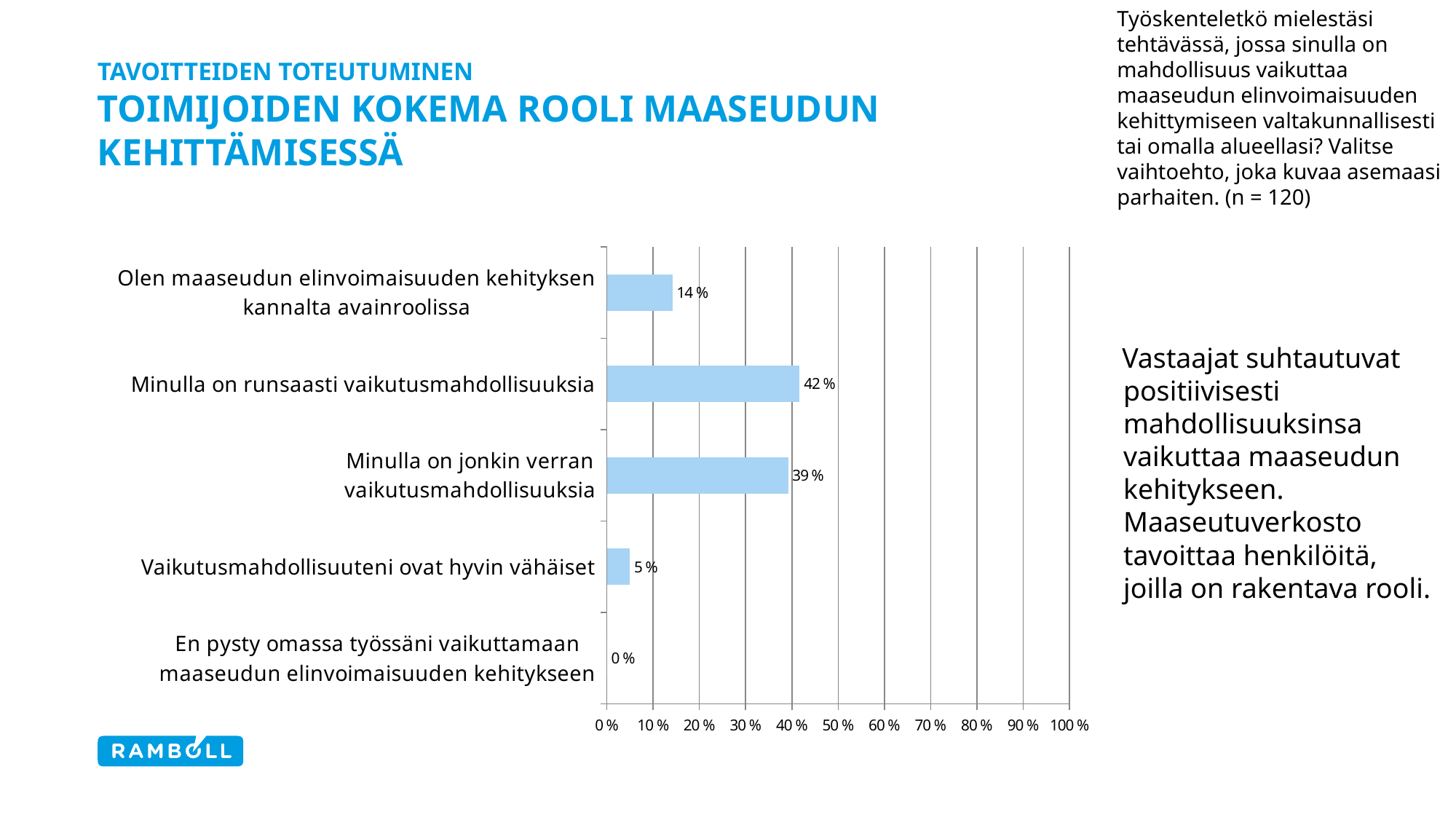
Which category has the lowest value? En pysty omassa työssäni vaikuttamaan maaseudun elinvoimaisuuden kehitykseen What is the difference between the values for "Minulla on runsaasti vaikutusmahdollisuuksia" and "Minulla on jonkin verran vaikutusmahdollisuuksia"? 3 % Which category has the highest value? Minulla on runsaasti vaikutusmahdollisuuksia What is the value for "Vaikutusmahdollisuuteni ovat hyvin vähäiset"? 5 % Which is larger: the value for "Olen maaseudun elinvoimaisuuden kehityksen kannalta avainroolissa" or for "Vaikutusmahdollisuuteni ovat hyvin vähäiset"? Olen maaseudun elinvoimaisuuden kehityksen kannalta avainroolissa What kind of chart is shown on the slide? bar chart What is the value for "Olen maaseudun elinvoimaisuuden kehityksen kannalta avainroolissa"? 14 % What is the maximum value shown on the x axis of the chart? 100 % Is the value for "Minulla on jonkin verran vaikutusmahdollisuuksia" greater or less than 30 %? greater What is the value for "En pysty omassa työssäni vaikuttamaan maaseudun elinvoimaisuuden kehitykseen"? 0 % What is the value for "Minulla on runsaasti vaikutusmahdollisuuksia"? 42 % How many categories are shown in the chart? 5